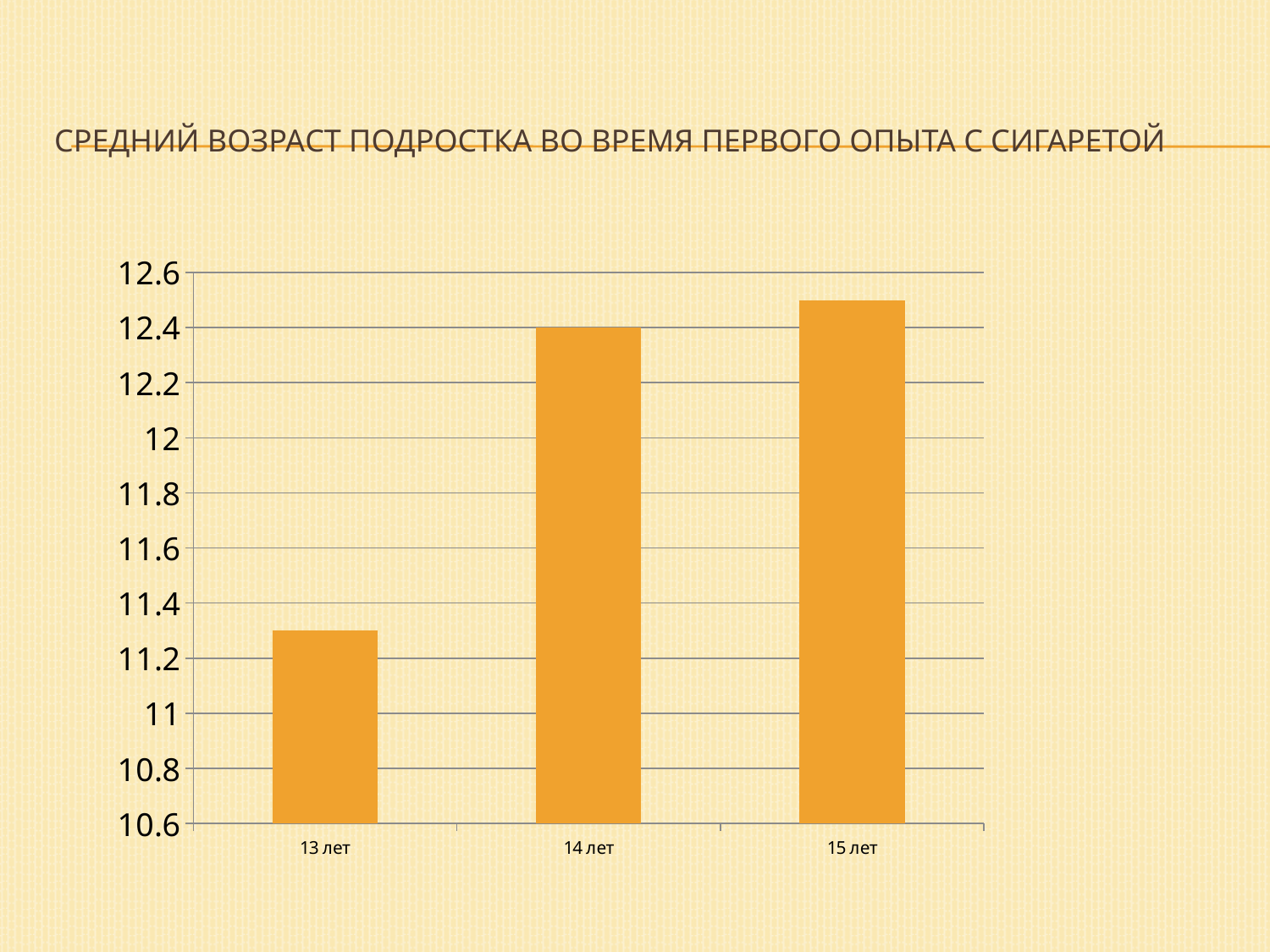
How many categories are shown on the x axis of the chart? 3 What kind of chart is shown on the slide? bar chart Is the value for 14 лет greater or less than 12? greater Do the values rise or fall from 13 лет to 15 лет along the x axis? rise What is the title of the slide? СРЕДНИЙ ВОЗРАСТ ПОДРОСТКА ВО ВРЕМЯ ПЕРВОГО ОПЫТА С СИГАРЕТОЙ Which category has the highest bar? 15 лет Which is larger, the value for 13 лет or the value for 14 лет? 14 лет Which category has the lowest bar? 13 лет Is the value for 13 лет greater or less than 11.2? greater What is the value for 14 лет? 12.4 Is the value for 13 лет greater or less than 11.4? less